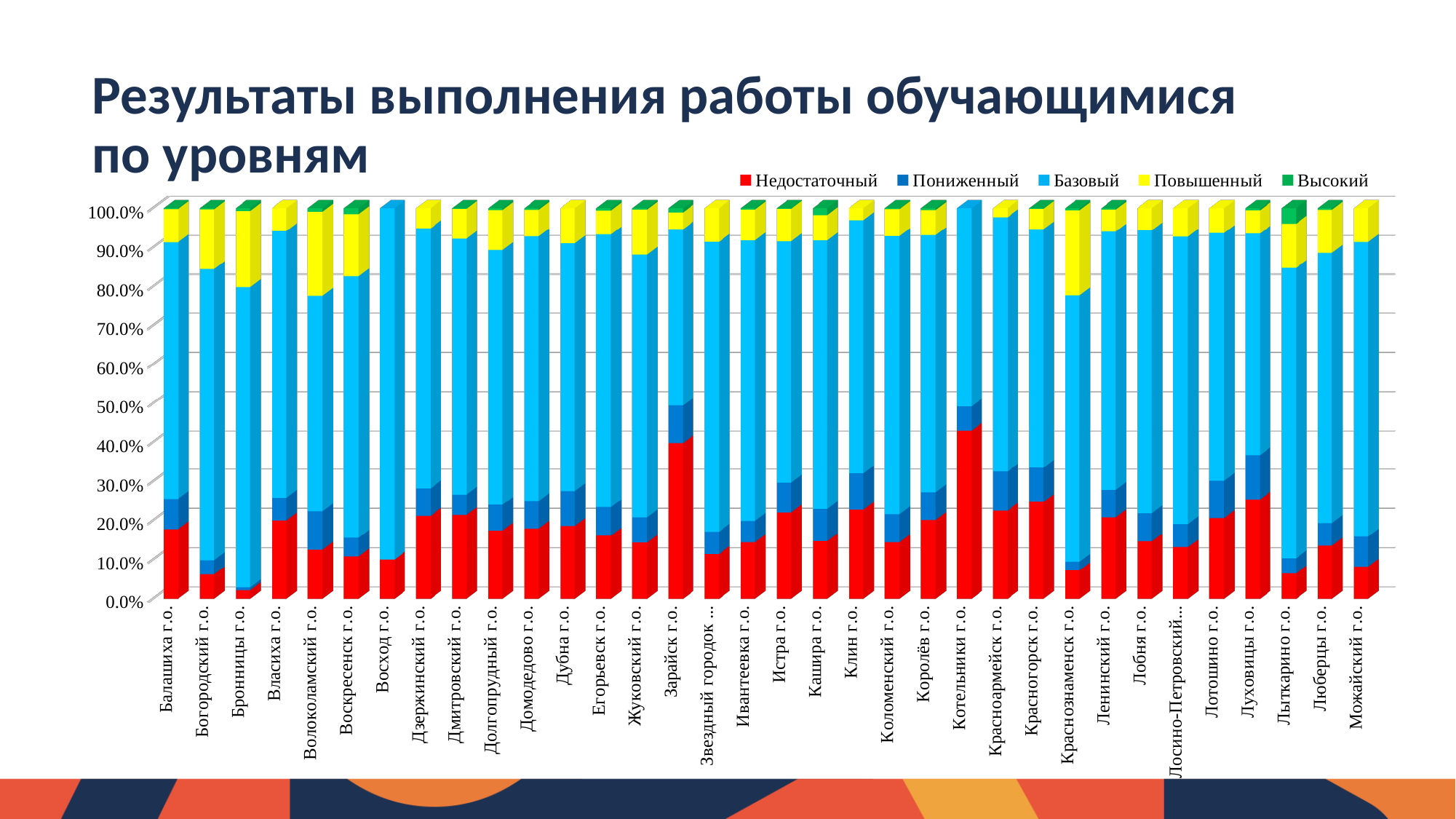
What kind of chart is shown on the slide? stacked bar chart Is the Недостаточный value for Бронницы г.о. greater or less than 10%? less Is the Недостаточный value for Котельники г.о. greater or less than 40%? greater Which series is shown in red in the legend? Недостаточный What is the title of the chart on the slide? Результаты выполнения работы обучающимися по уровням Is the Недостаточный value for Богородский г.о. greater or less than 10%? less How many categories (municipalities) are plotted along the x axis? 34 Which has the larger Недостаточный share, Котельники г.о. or Балашиха г.о.? Котельники г.о. How many series does the legend list? 5 Which category has the largest Высокий (green) share? Лыткарино г.о. Which category has the lowest Недостаточный share? Бронницы г.о.